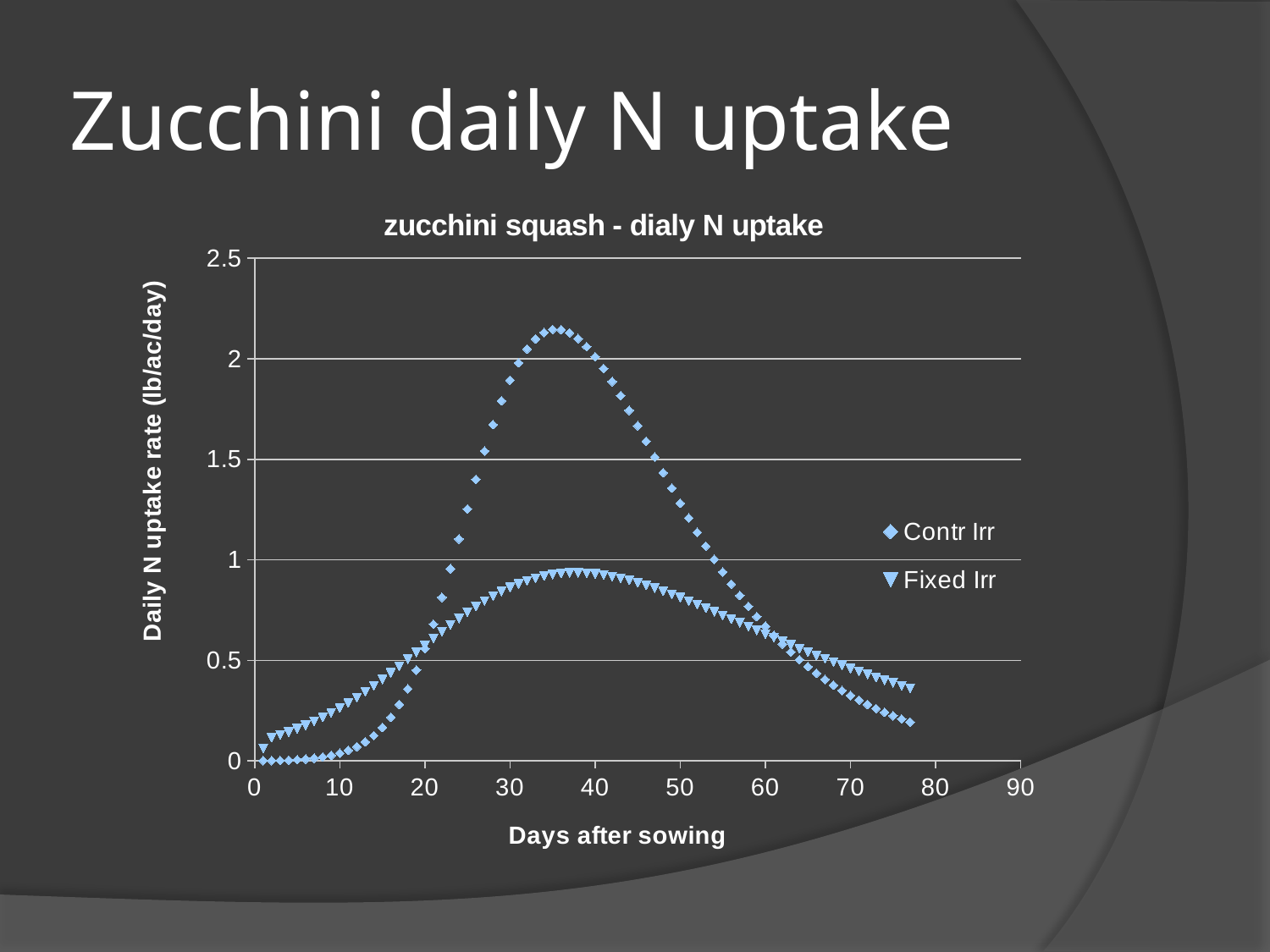
Is the Fixed Irr value at around 20 days after sowing greater or less than 0.5? greater What kind of chart is shown on the slide? Scatter chart How many series does the legend list? 2 Which series reaches the higher peak daily N uptake rate, Contr Irr or Fixed Irr? Contr Irr Is the Contr Irr value at around 50 days after sowing greater or less than 1.5? less Does the Contr Irr series rise and then fall, or rise steadily, as days after sowing increase? Rises and then falls What is the title of the chart? zucchini squash - dialy N uptake Is the peak value of the Contr Irr series greater or less than 2? greater At around 10 days after sowing, which series has the higher value, Contr Irr or Fixed Irr? Fixed Irr What are the two series named in the legend? Contr Irr and Fixed Irr At around 35 days after sowing, which series has the higher value, Contr Irr or Fixed Irr? Contr Irr